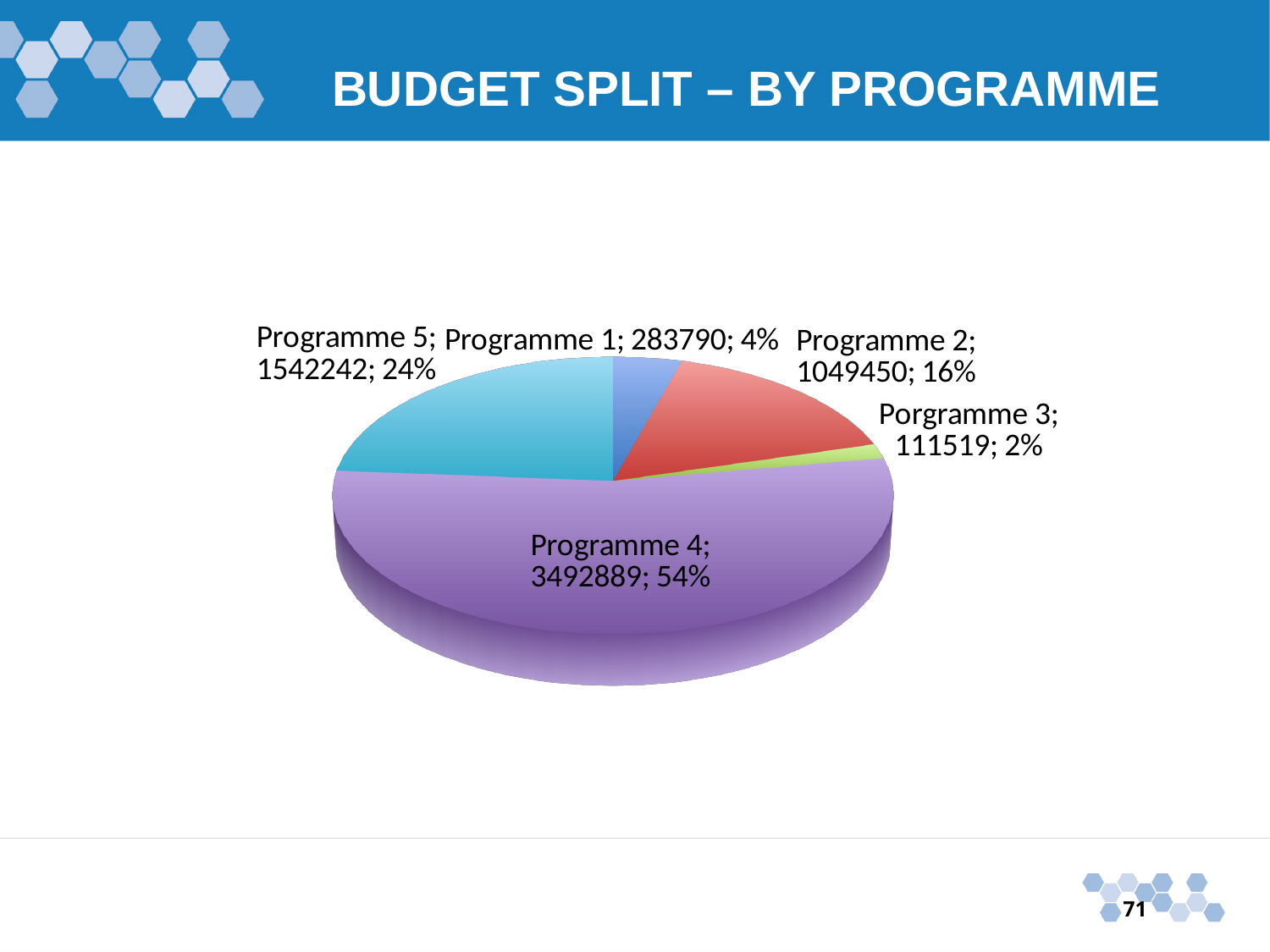
Which programme has the smallest share of the budget? Porgramme 3 Which has a larger budget, Programme 2 or Programme 5? Programme 5 What is the difference between the budget values of Programme 2 and Programme 1? 765660 Which programme has the largest share of the budget? Programme 4 What is the budget value for Programme 2? 1049450 What percentage share of the budget does Programme 3 have? 2% What is the difference between the budget values of Programme 4 and Programme 5? 1950647 What percentage share of the budget does Programme 5 have? 24% What type of chart is shown on the slide? Pie chart What is the budget value for Programme 1? 283790 What is the budget value for Programme 4? 3492889 How many programmes are shown in the pie chart? 5